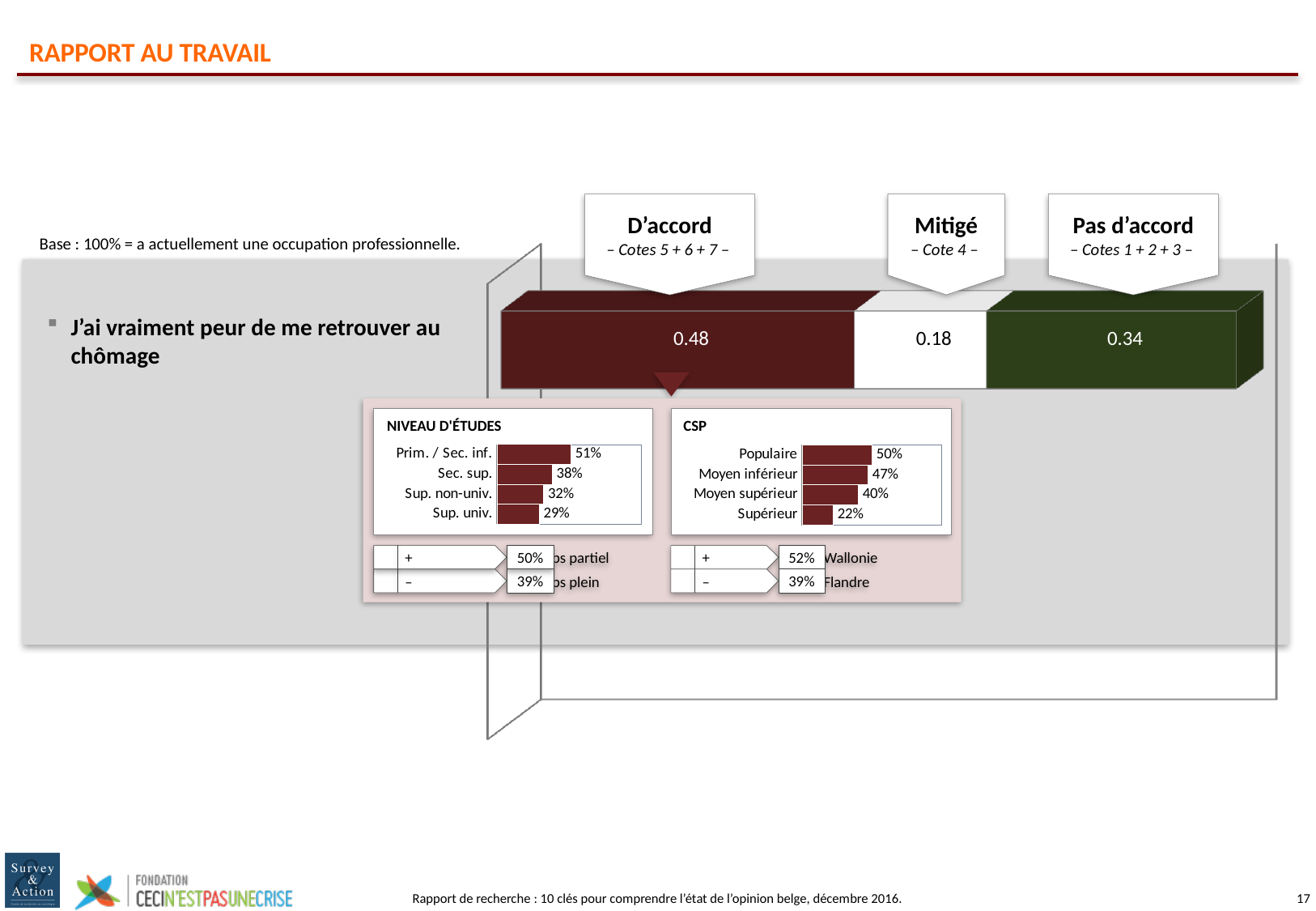
In the main stacked bar for 'J'ai vraiment peur de me retrouver au chômage', what is the value for 'D'accord'? 0.48 In the 'NIVEAU D'ÉTUDES' chart, how many categories are shown? 4 In the main stacked bar for 'J'ai vraiment peur de me retrouver au chômage', what is the value for 'Mitigé'? 0.18 In the 'CSP' chart, what is the value for 'Moyen supérieur'? 40% In the main stacked bar for 'J'ai vraiment peur de me retrouver au chômage', what is the value for 'Pas d'accord'? 0.34 In the 'NIVEAU D'ÉTUDES' chart, what is the value for 'Sec. sup.'? 38% In the 'CSP' chart, what is the difference between 'Populaire' and 'Supérieur'? 28% In the 'NIVEAU D'ÉTUDES' chart, do the values rise or fall from 'Prim. / Sec. inf.' down to 'Sup. univ.'? fall In the main stacked bar, which segment is the largest? D'accord In the main stacked bar, what is the difference between 'D'accord' and 'Pas d'accord'? 0.14 In the 'NIVEAU D'ÉTUDES' chart, which category has the lowest value? Sup. univ. What kind of chart is the 'CSP' chart? bar chart